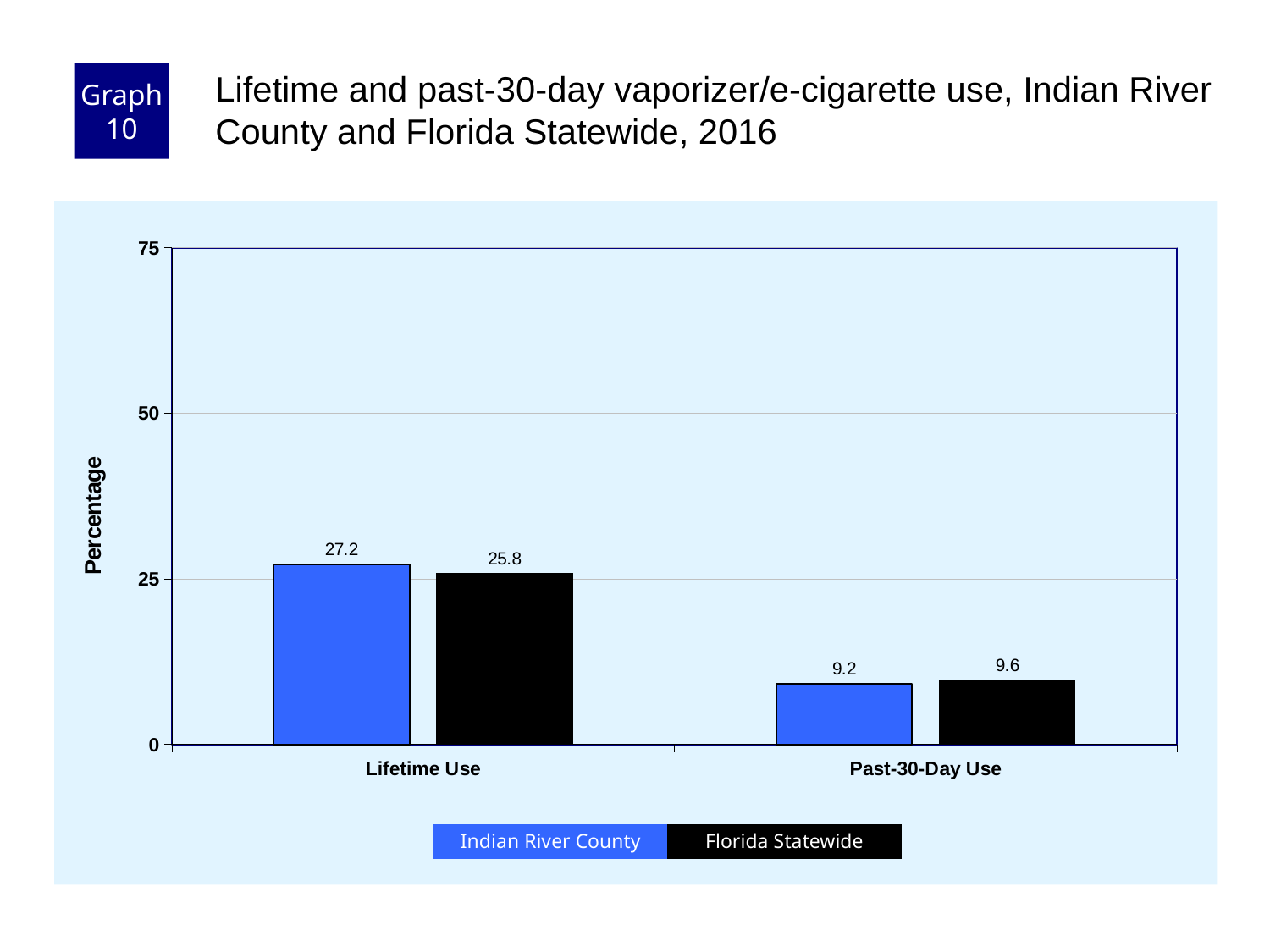
What is the Indian River County value for Lifetime Use? 27.2 Which bar has the lowest value on the chart? Indian River County, Past-30-Day Use What is the difference between the Indian River County and Florida Statewide values for Lifetime Use? 1.4 Which bar has the highest value on the chart? Indian River County, Lifetime Use What type of chart is shown? Bar chart Is the Indian River County value for Lifetime Use greater or less than 25? greater What is the Florida Statewide value for Lifetime Use? 25.8 For Past-30-Day Use, which is larger: Indian River County or Florida Statewide? Florida Statewide How many categories are shown on the x axis? 2 What is the difference between the Florida Statewide and Indian River County values for Past-30-Day Use? 0.4 How many series does the legend list? 2 What is the Florida Statewide value for Past-30-Day Use? 9.6